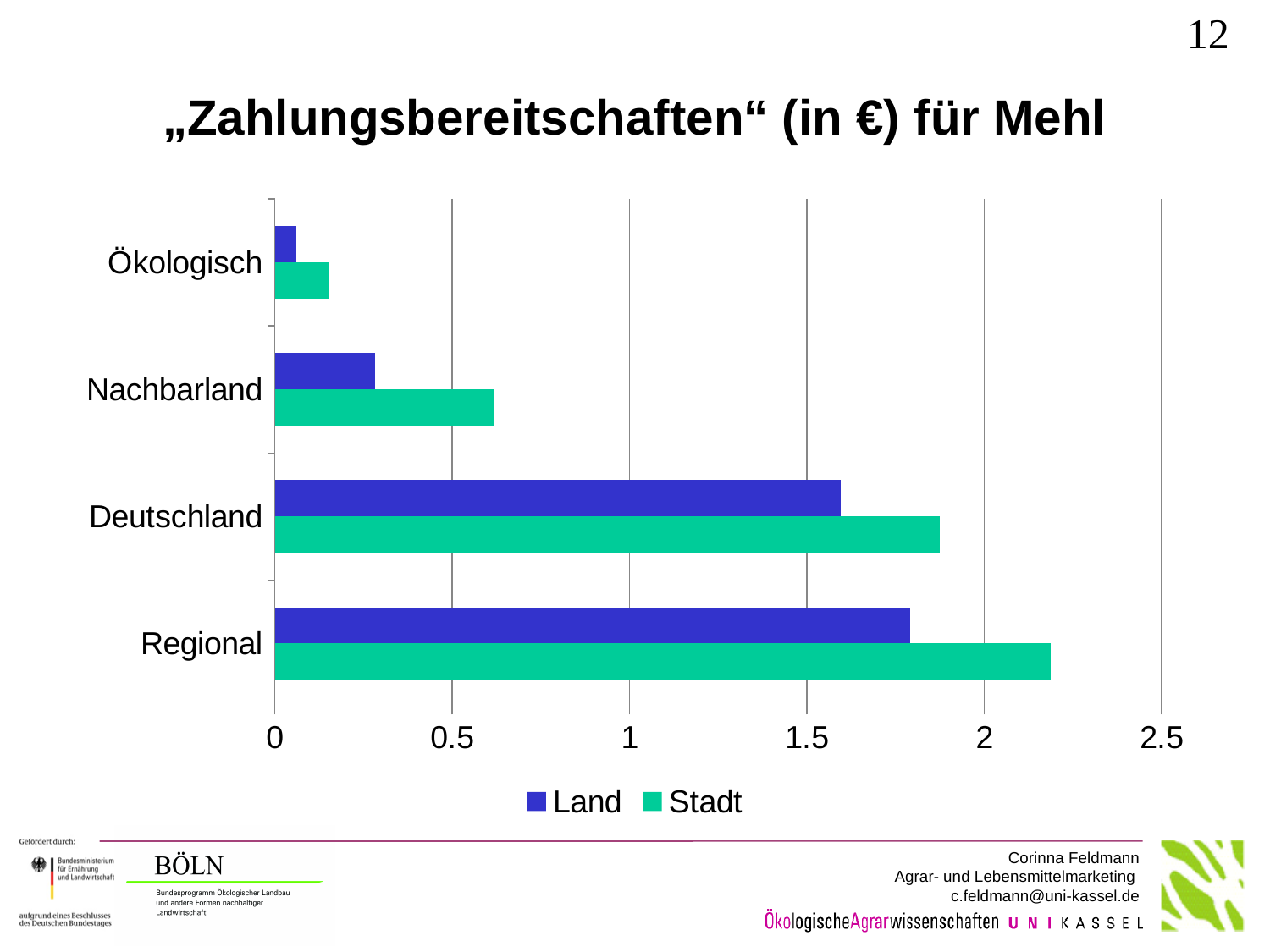
Is the Land value for Deutschland greater or less than 1.5? greater How many categories are shown on the chart? 4 What kind of chart is shown on the slide? bar chart What is the title of the chart? „Zahlungsbereitschaften“ (in €) für Mehl Which category has the highest value for the Stadt series? Regional Is the Stadt value for Regional greater or less than 2? greater How many series does the legend list? 2 Which category has the lowest value for the Land series? Ökologisch Is the Stadt value for Nachbarland greater or less than 1? less Which is larger: the Land value for Regional or the Land value for Nachbarland? Regional For Deutschland, which series has the larger value, Land or Stadt? Stadt